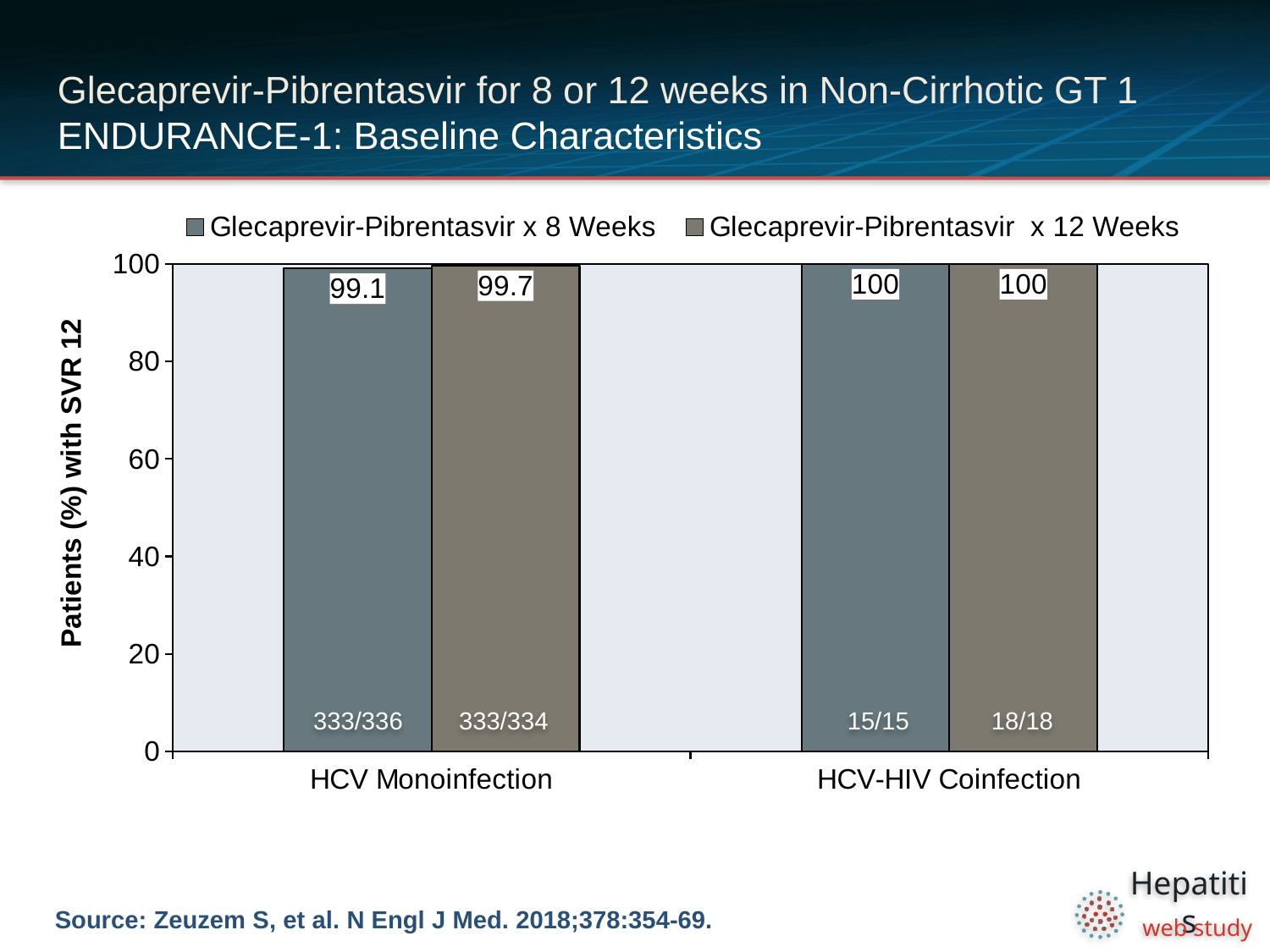
How many patient groups are shown on the x axis? 2 In the HCV Monoinfection group, which arm has the higher SVR 12 rate, 8 weeks or 12 weeks? Glecaprevir-Pibrentasvir x 12 Weeks What is the SVR 12 rate for Glecaprevir-Pibrentasvir x 12 Weeks in the HCV Monoinfection group? 99.7 What is the label of the y axis? Patients (%) with SVR 12 What is the SVR 12 rate for Glecaprevir-Pibrentasvir x 8 Weeks in the HCV Monoinfection group? 99.1 What is the SVR 12 rate for Glecaprevir-Pibrentasvir x 8 Weeks in the HCV-HIV Coinfection group? 100 What fraction of patients is shown for Glecaprevir-Pibrentasvir x 12 Weeks in the HCV-HIV Coinfection group? 18/18 How many series does the legend list? 2 What type of chart is shown on the slide? Bar chart What fraction of patients is shown for Glecaprevir-Pibrentasvir x 8 Weeks in the HCV Monoinfection group? 333/336 What is the difference in SVR 12 rate between the 12-week and 8-week arms in the HCV Monoinfection group? 0.6 Which bar has the lowest SVR 12 rate on the chart? Glecaprevir-Pibrentasvir x 8 Weeks, HCV Monoinfection